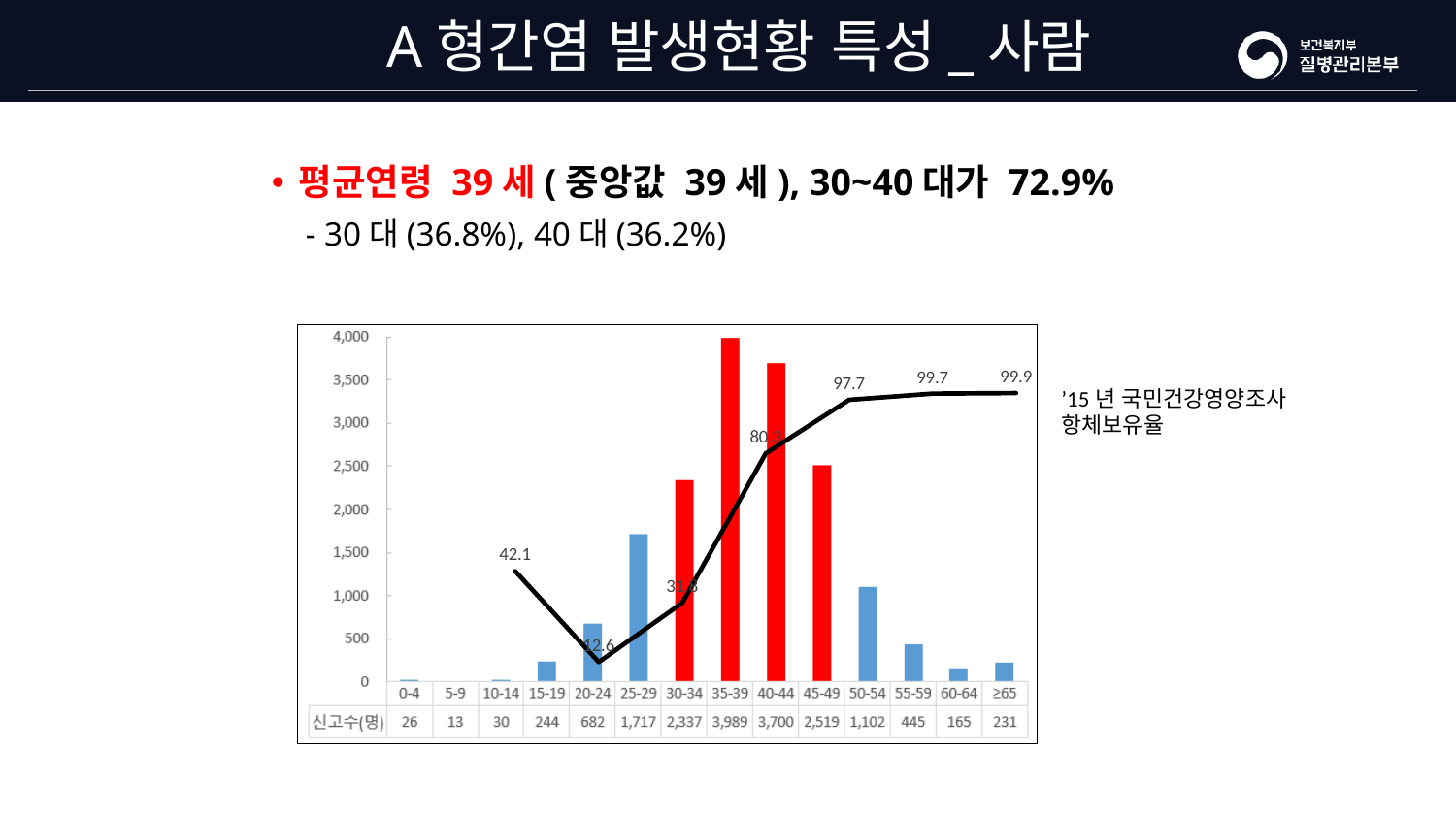
Which age group has the highest 신고수(명)? 35-39 Is the bar for the 50-54 age group greater or less than 1,000? greater What is the 신고수(명) value for the 35-39 age group? 3,989 What kind of chart is used to show the 신고수(명) values? bar chart What is the 신고수(명) value for the ≥65 age group? 231 What is the difference in 신고수(명) between the 25-29 and 20-24 age groups? 1,035 What is the difference in 신고수(명) between the 35-39 and 40-44 age groups? 289 What is the 신고수(명) value for the 20-24 age group? 682 Which age group has a larger 신고수(명), 30-34 or 45-49? 45-49 How many age group categories are shown on the x axis? 14 Do the bar values rise or fall from the 35-39 age group to the 60-64 age group? fall Which age group has the lowest 신고수(명)? 5-9